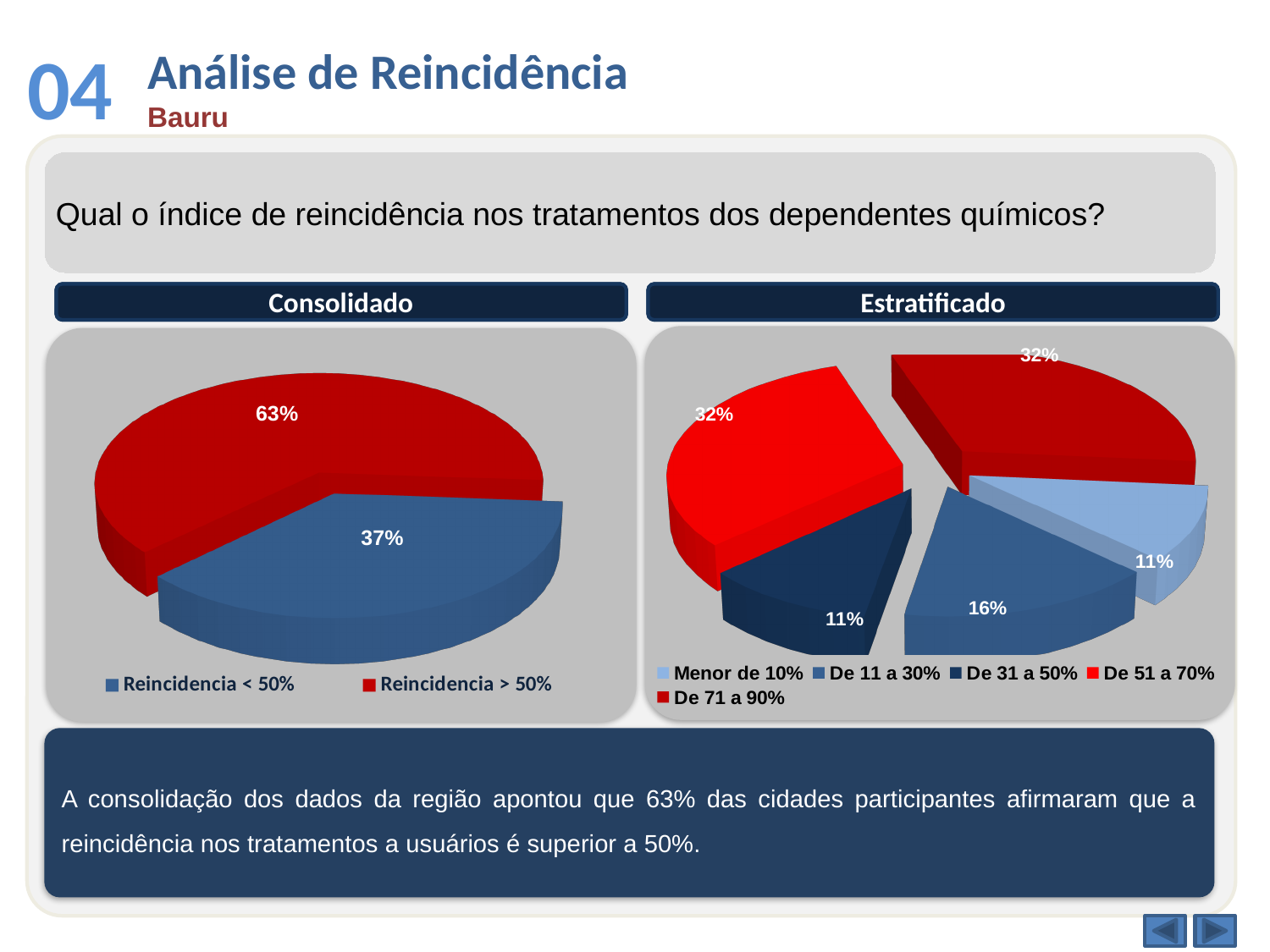
How many categories does the legend of the Estratificado chart list? 5 In the Estratificado chart, what share is labelled for 'De 51 a 70%'? 32% What kind of chart is the Consolidado chart? Pie chart In the Consolidado chart, what is the difference in percentage points between 'Reincidencia > 50%' and 'Reincidencia < 50%'? 26 percentage points How many series does the legend of the Consolidado chart list? 2 In the Estratificado chart, which is larger: 'De 11 a 30%' or 'De 31 a 50%'? De 11 a 30% In the Consolidado chart, what share of the pie is labelled 'Reincidencia > 50%'? 63% In the Consolidado chart, which category has the largest slice? Reincidencia > 50% In the Estratificado chart, what is the combined share of 'De 51 a 70%' and 'De 71 a 90%'? 64% In the Consolidado chart, what share of the pie is labelled 'Reincidencia < 50%'? 37% In the Estratificado chart, what share is labelled for 'Menor de 10%'? 11% In the Estratificado chart, what share is labelled for 'De 11 a 30%'? 16%